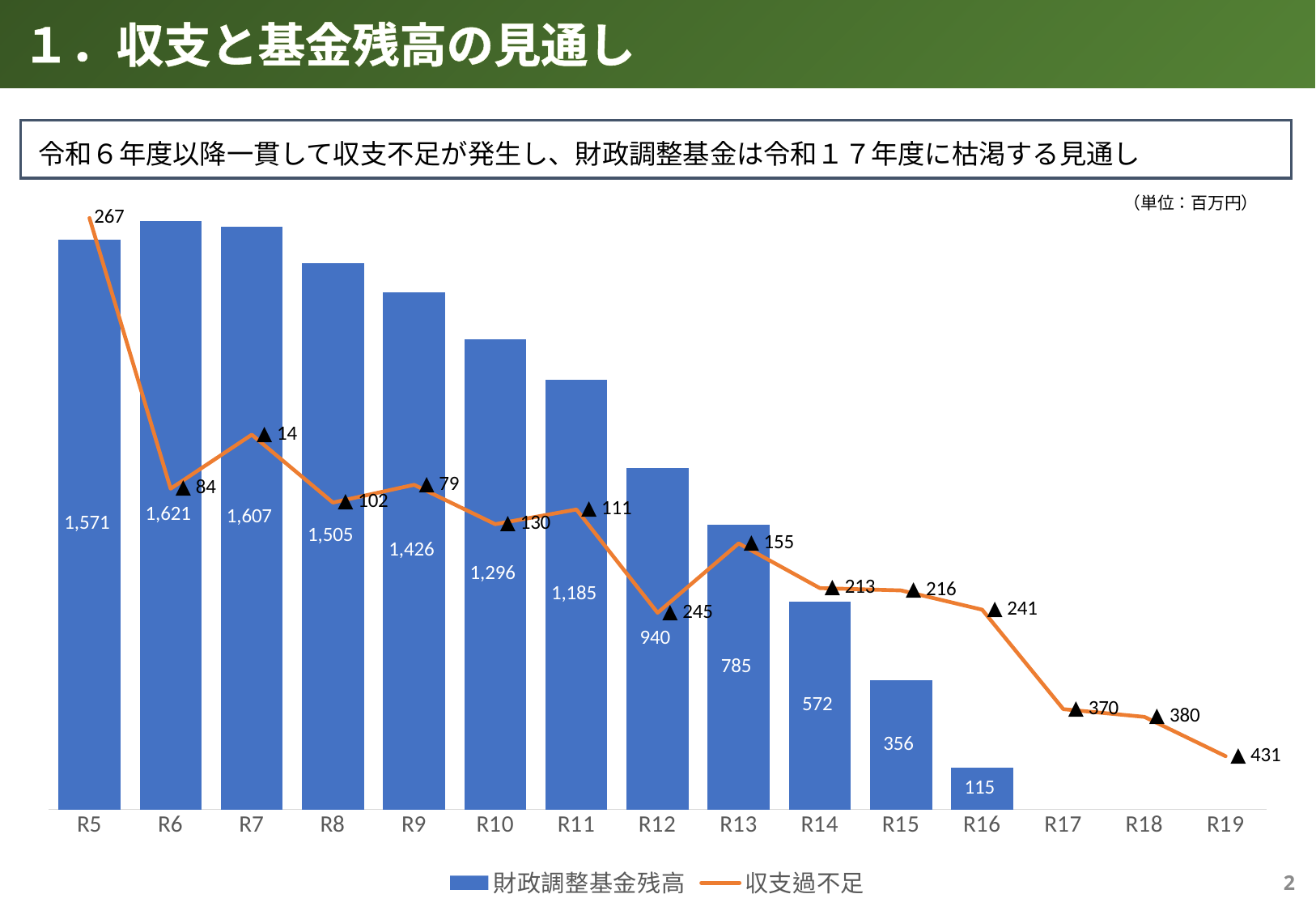
What is the difference between the 財政調整基金残高 for R6 and R7? 14 Which year has the highest 財政調整基金残高? R6 How many series does the legend list? 2 What is the value of 収支過不足 for R5? 267 What unit is stated for the chart values? 百万円 What is the value of 財政調整基金残高 for R9? 1,426 Which is larger, the 財政調整基金残高 for R13 or for R14? R13 Which year has the lowest 財政調整基金残高 among the years with a bar? R16 What is the value of 収支過不足 for R12? ▲245 How many years are shown on the x axis? 15 What kind of chart is this? Combined bar and line chart Does the 財政調整基金残高 rise or fall from R7 to R16? Fall